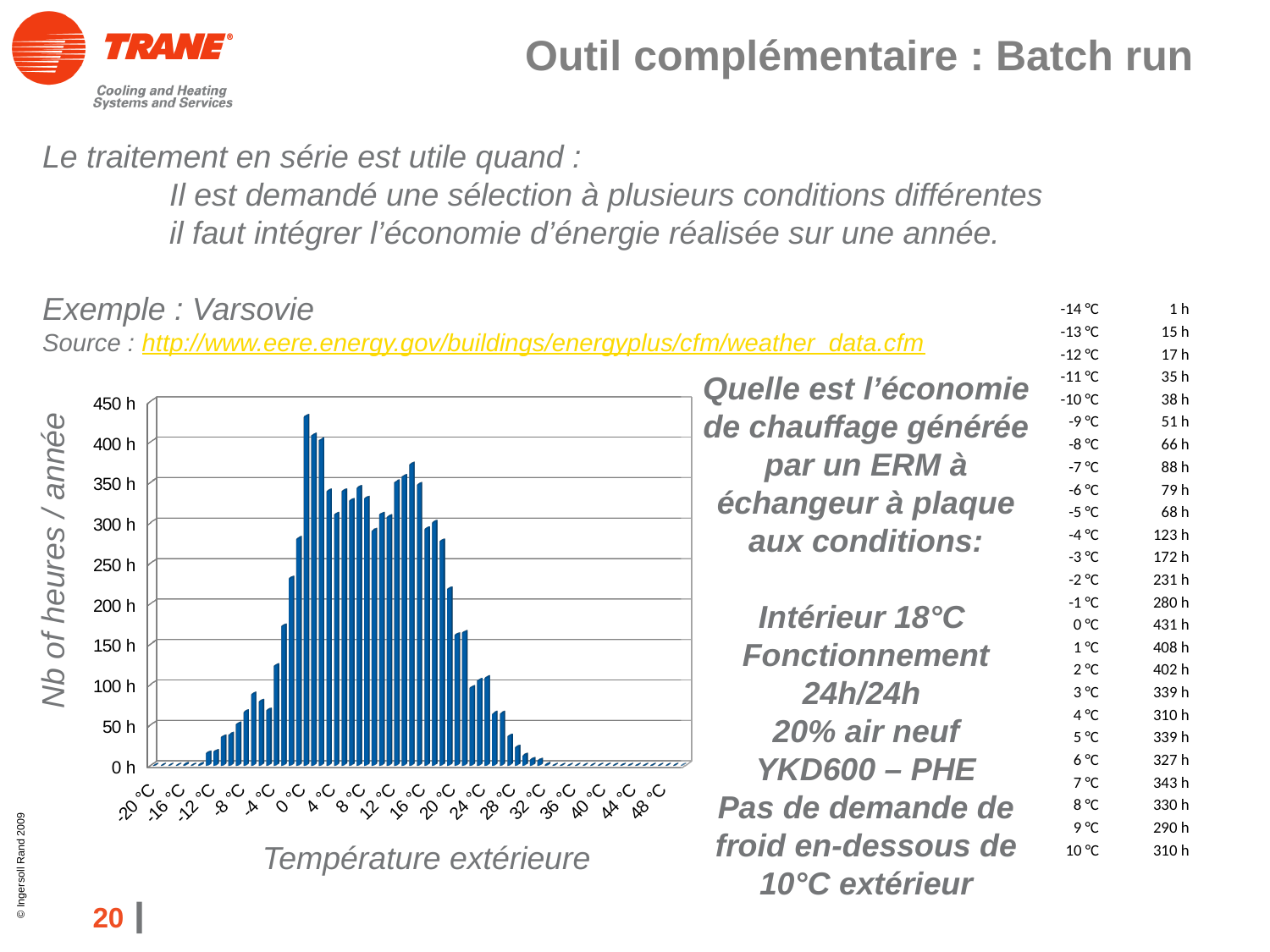
Which has more hours per year, 0 °C or 4 °C? 0 °C At which outdoor temperature is the number of hours per year highest? 0 °C Using the table values, what is the difference in hours between 0 °C and 1 °C? 23 h According to the table on the slide, how many hours per year are at -14 °C? 1 h What is the title of the y axis of the chart? Nb of heures / année What kind of chart is shown on the slide? bar chart Is the value for 0 °C greater or less than 400 h? greater According to the table on the slide, how many hours per year are at 10 °C? 310 h What is the title of the x axis of the chart? Température extérieure According to the table on the slide, how many hours per year are at 0 °C? 431 h Is the value for 40 °C greater or less than 50 h? less Do the values rise or fall as the temperature goes from -14 °C to 0 °C? rise